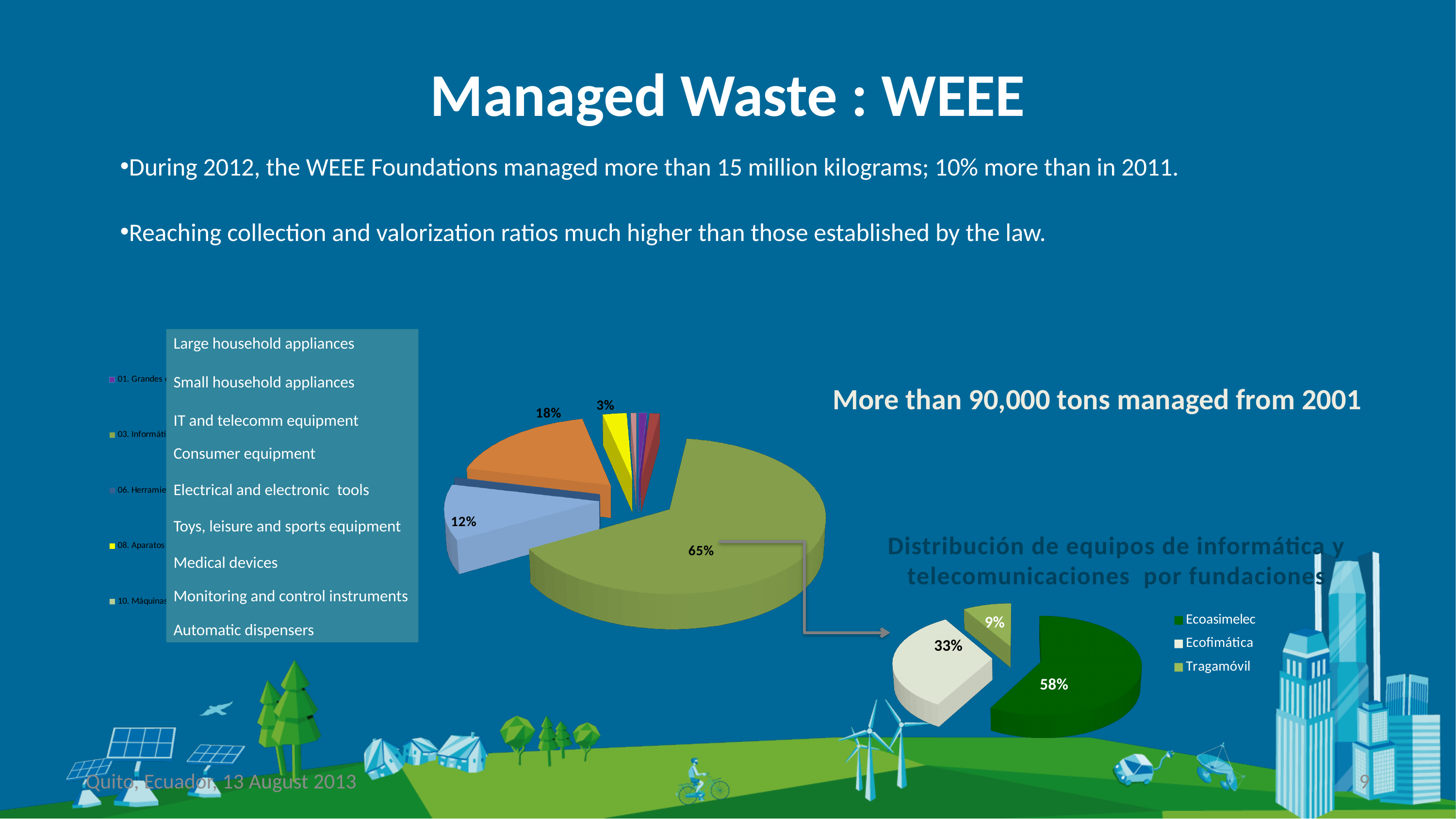
In the large pie chart in the centre of the slide, what is the share of the largest slice? 65% In the pie chart on the lower right, which is larger: Ecofimática or Tragamóvil? Ecofimática How many entries does the legend of the pie chart on the lower right list? 3 In the pie chart titled 'Distribución de equipos de informática y telecomunicaciones por fundaciones', what share does Ecoasimelec have? 58% In the pie chart on the lower right, how many percentage points larger is Ecoasimelec's share than Ecofimática's? 25% In the large pie chart in the centre of the slide, what is the difference between the 18% slice and the 12% slice? 6% What kind of chart is the chart on the lower right of the slide? Pie chart In the large pie chart in the centre of the slide, how many slices have a percentage label printed? 4 In the pie chart titled 'Distribución de equipos de informática y telecomunicaciones por fundaciones', what share does Tragamóvil have? 9% In the pie chart on the lower right, which foundation has the smallest share? Tragamóvil In the pie chart on the lower right, which foundation has the largest share? Ecoasimelec In the pie chart titled 'Distribución de equipos de informática y telecomunicaciones por fundaciones', what share does Ecofimática have? 33%